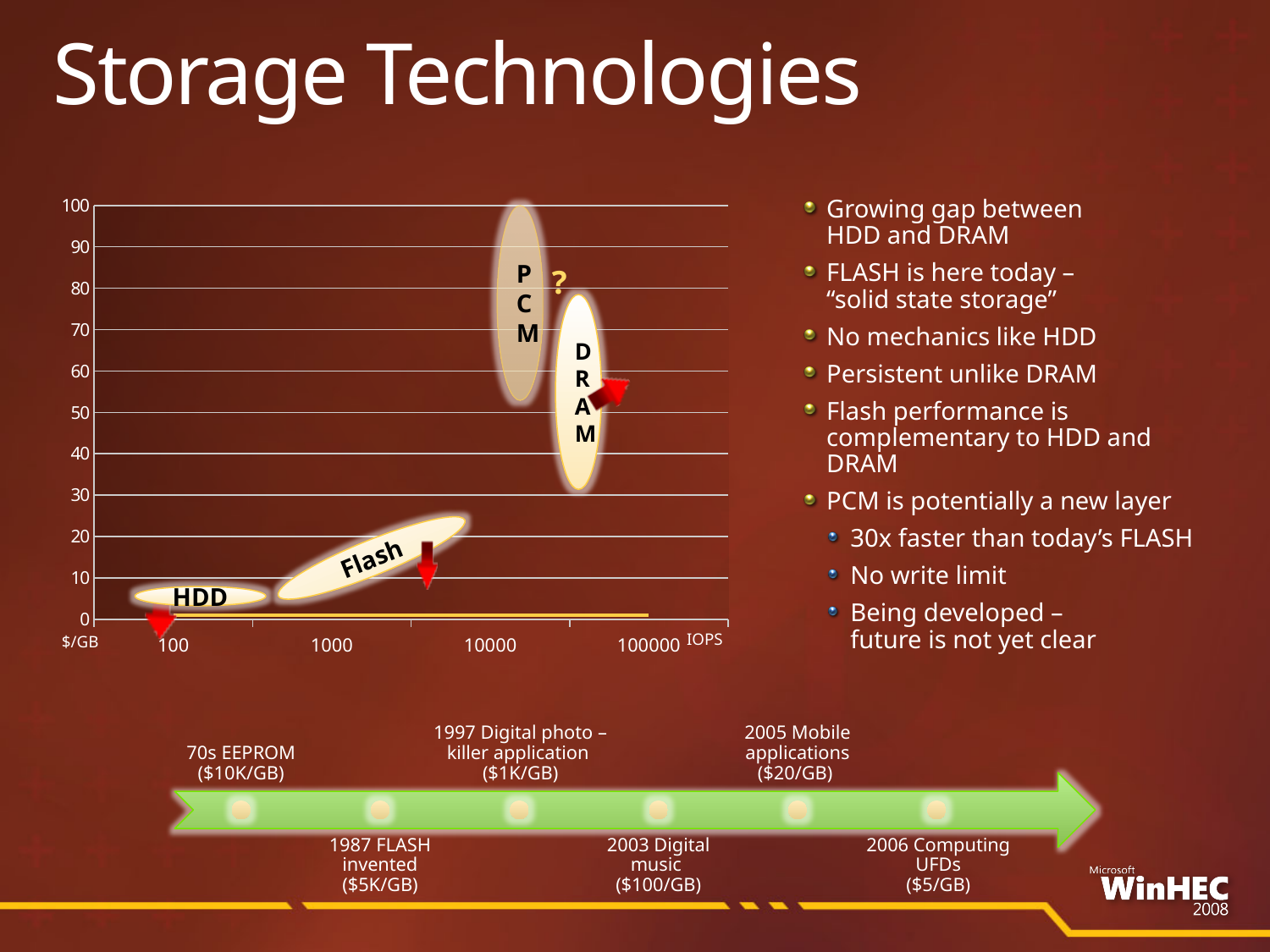
Which storage technology is positioned highest on the $/GB axis? PCM Which storage technology is positioned lowest on the $/GB axis? HDD Is the $/GB value for PCM greater or less than 60? greater Which has the higher IOPS on the chart, Flash or DRAM? DRAM Is the $/GB value for HDD greater or less than 10? less Which has the higher IOPS on the chart, HDD or Flash? Flash What is the highest value shown on the y axis of the chart? 100 Is the $/GB value for DRAM greater or less than 30? greater How many storage technologies are labelled on the chart? 4 Which has the higher $/GB on the chart, HDD or DRAM? DRAM What unit is shown on the y axis of the chart? $/GB What unit is shown on the x axis of the chart? IOPS